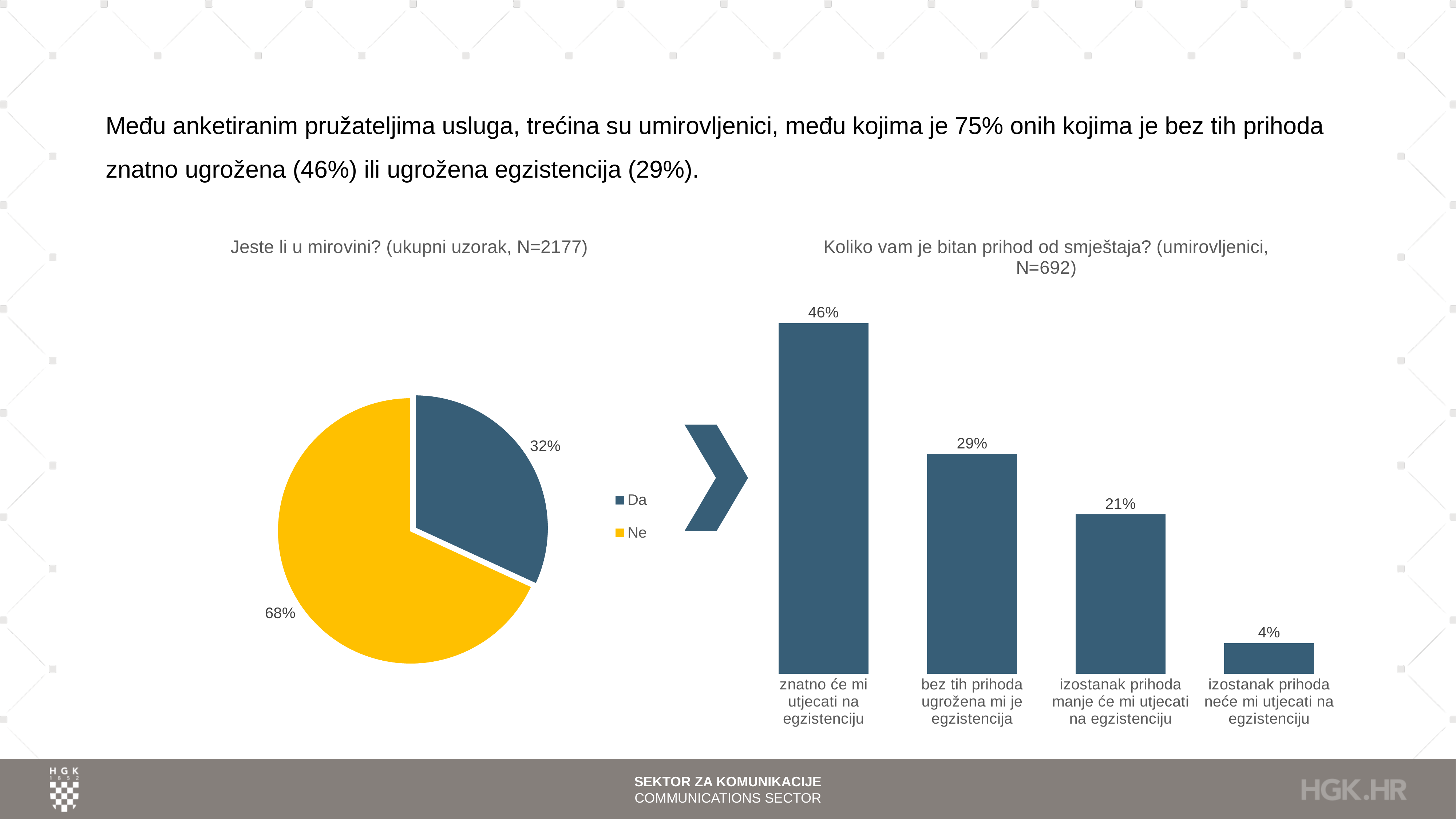
In the pie chart 'Jeste li u mirovini?', what share of respondents answered 'Da'? 32% In the pie chart 'Jeste li u mirovini?', what share of respondents answered 'Ne'? 68% In the bar chart 'Koliko vam je bitan prihod od smještaja?', what is the value for 'izostanak prihoda manje će mi utjecati na egzistenciju'? 21% In the bar chart 'Koliko vam je bitan prihod od smještaja?', which category has the lowest value? izostanak prihoda neće mi utjecati na egzistenciju What kind of chart is the chart on the right of the slide ('Koliko vam je bitan prihod od smještaja?')? Bar chart In the bar chart 'Koliko vam je bitan prihod od smještaja?', how many categories are shown? 4 In the pie chart 'Jeste li u mirovini?', what is the difference between the 'Ne' and 'Da' shares? 36% In the pie chart 'Jeste li u mirovini?', which answer has the larger slice? Ne In the bar chart 'Koliko vam je bitan prihod od smještaja?', what is the value for 'znatno će mi utjecati na egzistenciju'? 46% What kind of chart is the chart on the left of the slide? Pie chart In the pie chart 'Jeste li u mirovini?', how many entries does the legend list? 2 In the bar chart 'Koliko vam je bitan prihod od smještaja?', what is the difference between 'znatno će mi utjecati na egzistenciju' and 'bez tih prihoda ugrožena mi je egzistencija'? 17%